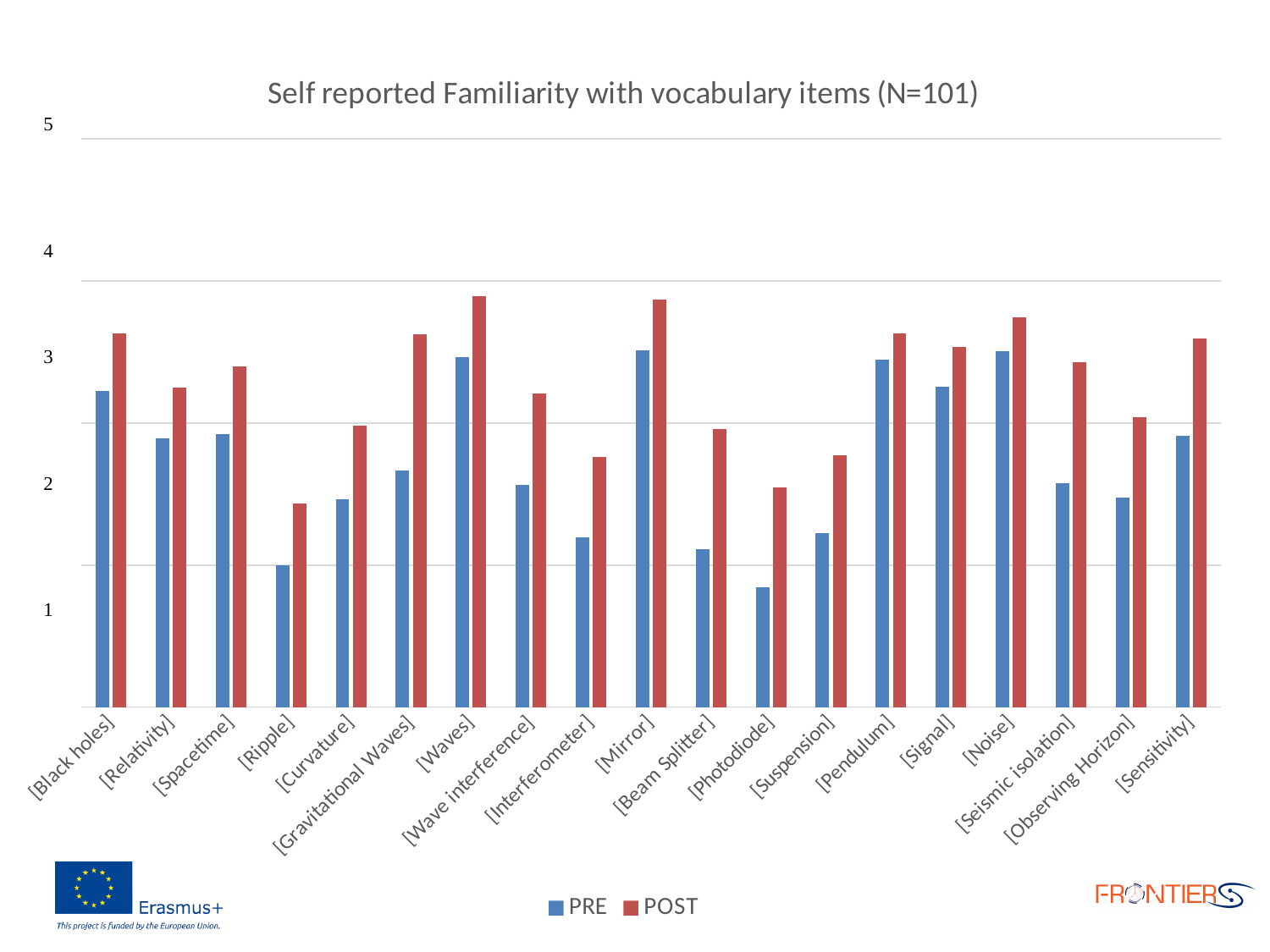
Which vocabulary item has the lowest PRE value? [Photodiode] What is the title of the chart? Self reported Familiarity with vocabulary items (N=101) Which vocabulary item has the lowest POST value? [Ripple] What kind of chart is shown on the slide? bar chart Is the PRE value for [Photodiode] greater or less than 2? less How many vocabulary items (categories) are shown on the x axis? 19 Is the POST value for [Waves] greater or less than 3? greater What are the two series named in the legend? PRE and POST Which is larger, the PRE value for [Waves] or the PRE value for [Ripple]? [Waves] For [Black holes], which is larger, the PRE value or the POST value? POST Is the POST value for [Interferometer] greater or less than 3? less How many series does the legend list? 2